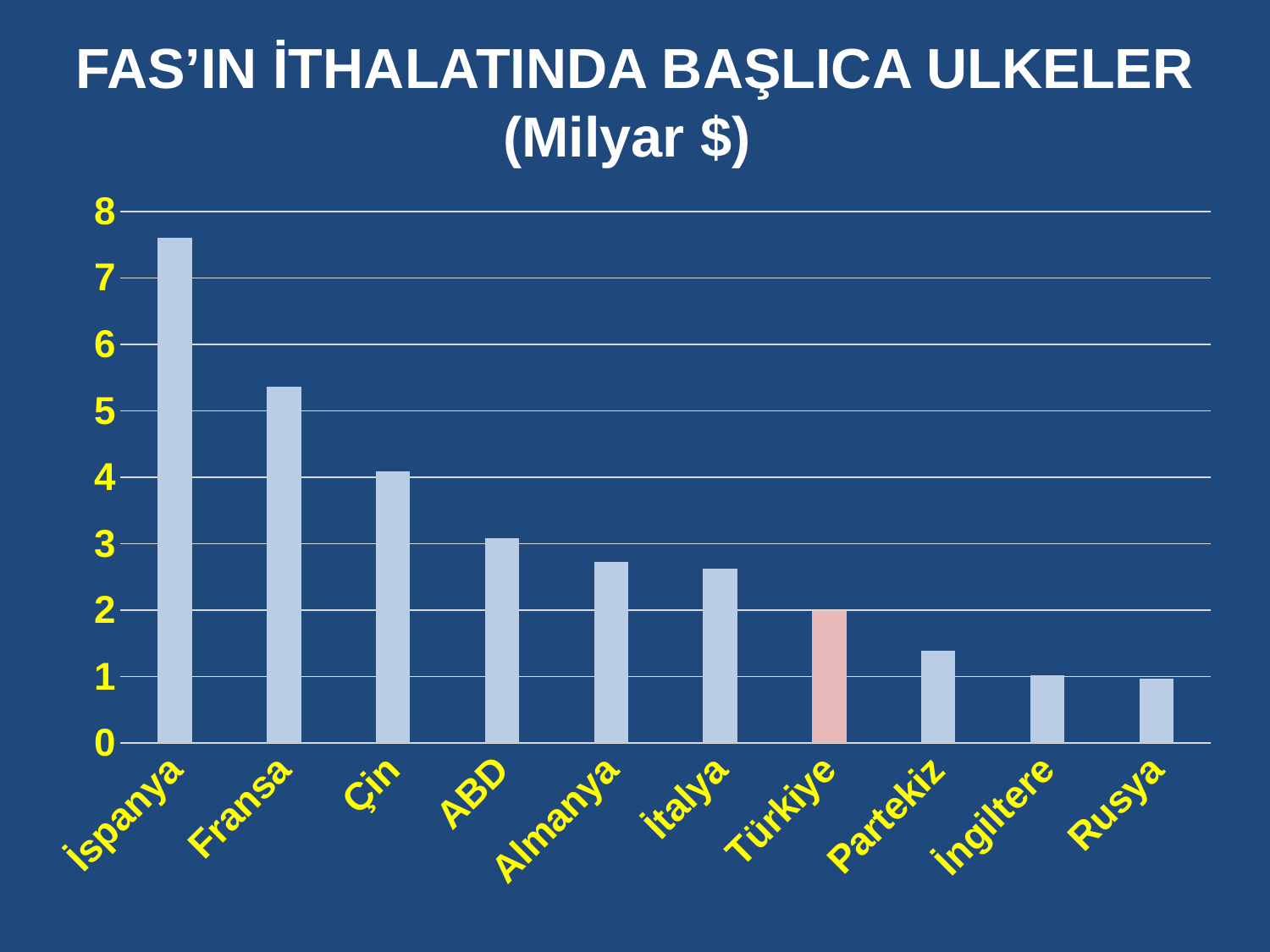
Is the value for Fransa greater or less than 5? greater Is the value for Almanya greater or less than 3? less How many countries are shown on the chart? 10 Which country has the highest value on the chart? İspanya Do the values rise or fall moving from left to right along the x axis? fall Which has a larger value, Türkiye or Partekiz? Türkiye Which country's bar is shown in a different colour from the others? Türkiye Is the value for İspanya greater or less than 7? greater What kind of chart is shown on the slide? bar chart Which has a larger value, Fransa or Çin? Fransa